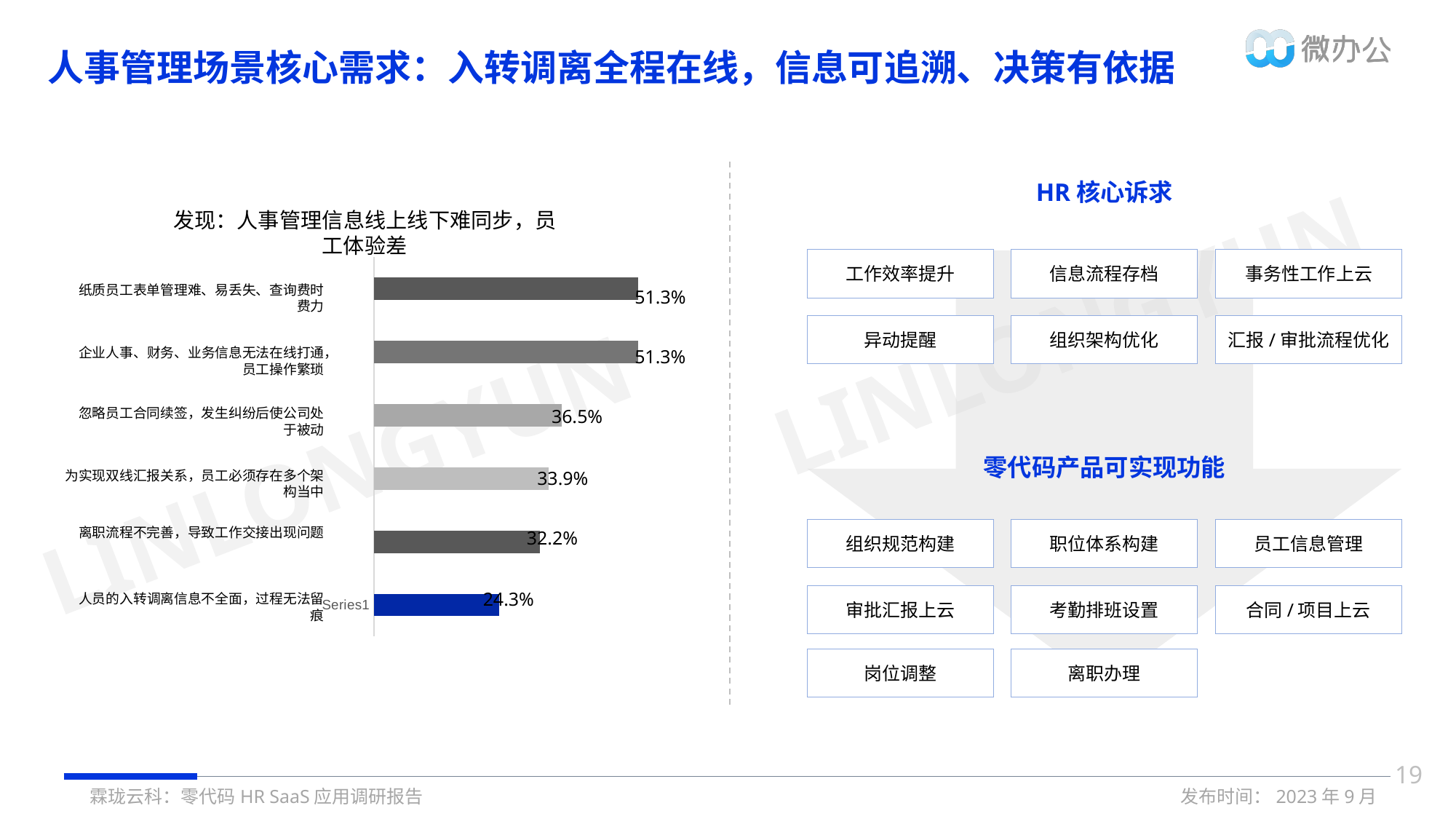
What is the difference between the value for "企业人事、财务、业务信息无法在线打通，员工操作繁琐" and the value for "人员的入转调离信息不全面，过程无法留痕"? 27.0% What is the title of the chart? 发现：人事管理信息线上线下难同步，员工体验差 What is the value for "人员的入转调离信息不全面，过程无法留痕"? 24.3% Which is larger: the value for "忽略员工合同续签，发生纠纷后使公司处于被动" or the value for "离职流程不完善，导致工作交接出现问题"? 忽略员工合同续签，发生纠纷后使公司处于被动 What is the value for "离职流程不完善，导致工作交接出现问题"? 32.2% How many categories are shown in the chart? 6 What is the value for "纸质员工表单管理难、易丢失、查询费时费力"? 51.3% Which category has the lowest value? 人员的入转调离信息不全面，过程无法留痕 What is the value for "忽略员工合同续签，发生纠纷后使公司处于被动"? 36.5% What type of chart is shown on the slide? Bar chart What is the value for "为实现双线汇报关系，员工必须存在多个架构当中"? 33.9% What is the difference between the value for "忽略员工合同续签，发生纠纷后使公司处于被动" and the value for "为实现双线汇报关系，员工必须存在多个架构当中"? 2.6%